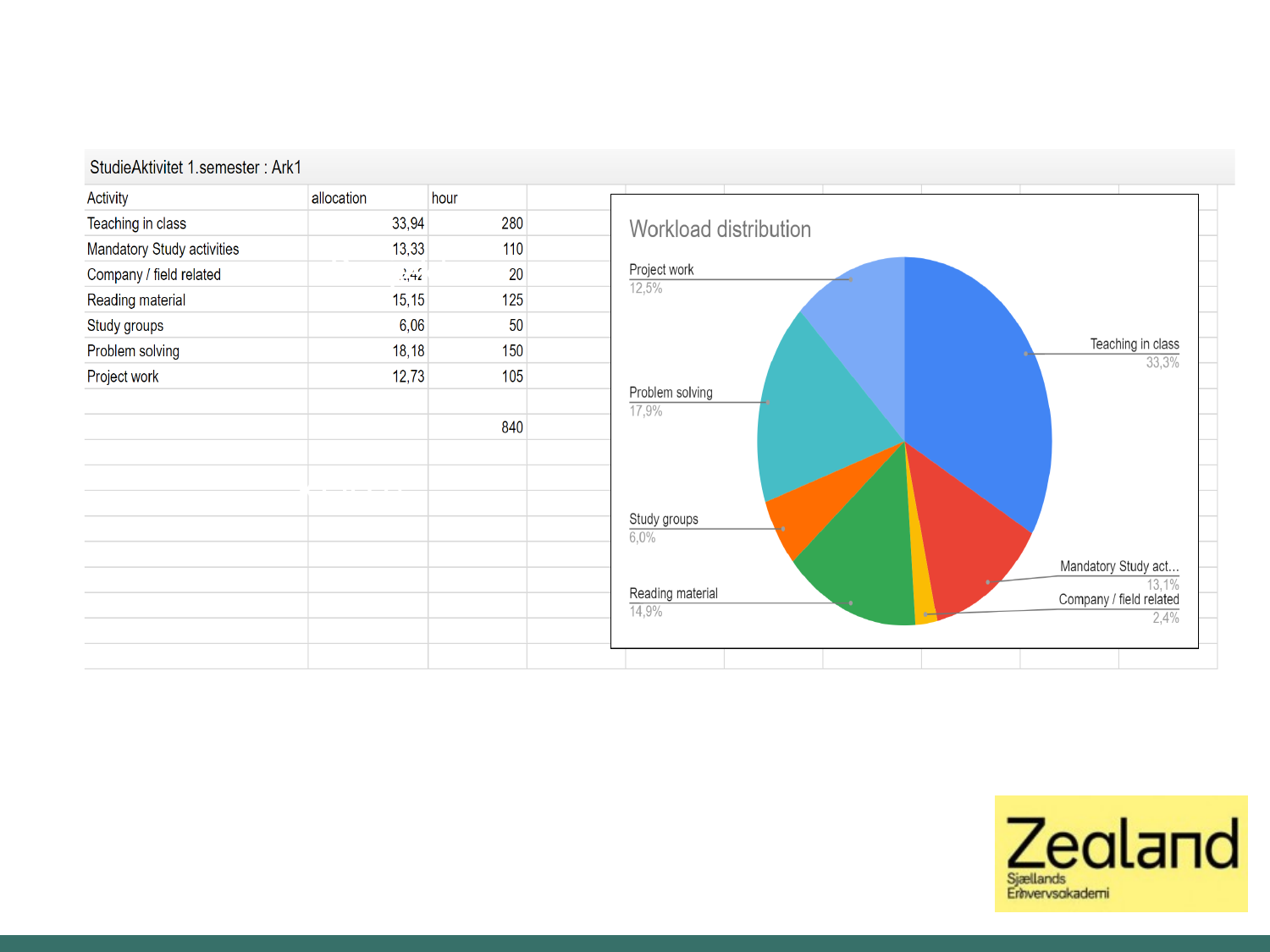
What is the title of the chart? Workload distribution Which category has the smallest slice of the pie? Company / field related What share of the pie does Teaching in class have? 33,3% What kind of chart is shown on the slide? pie chart What share of the pie does Company / field related have? 2,4% Which is larger, the share for Problem solving or the share for Reading material? Problem solving What share of the pie does Project work have? 12,5% How many slices does the pie chart have? 7 What share of the pie does Problem solving have? 17,9% Which category has the largest slice of the pie? Teaching in class What share of the pie does Reading material have? 14,9% What share of the pie does Study groups have? 6,0%